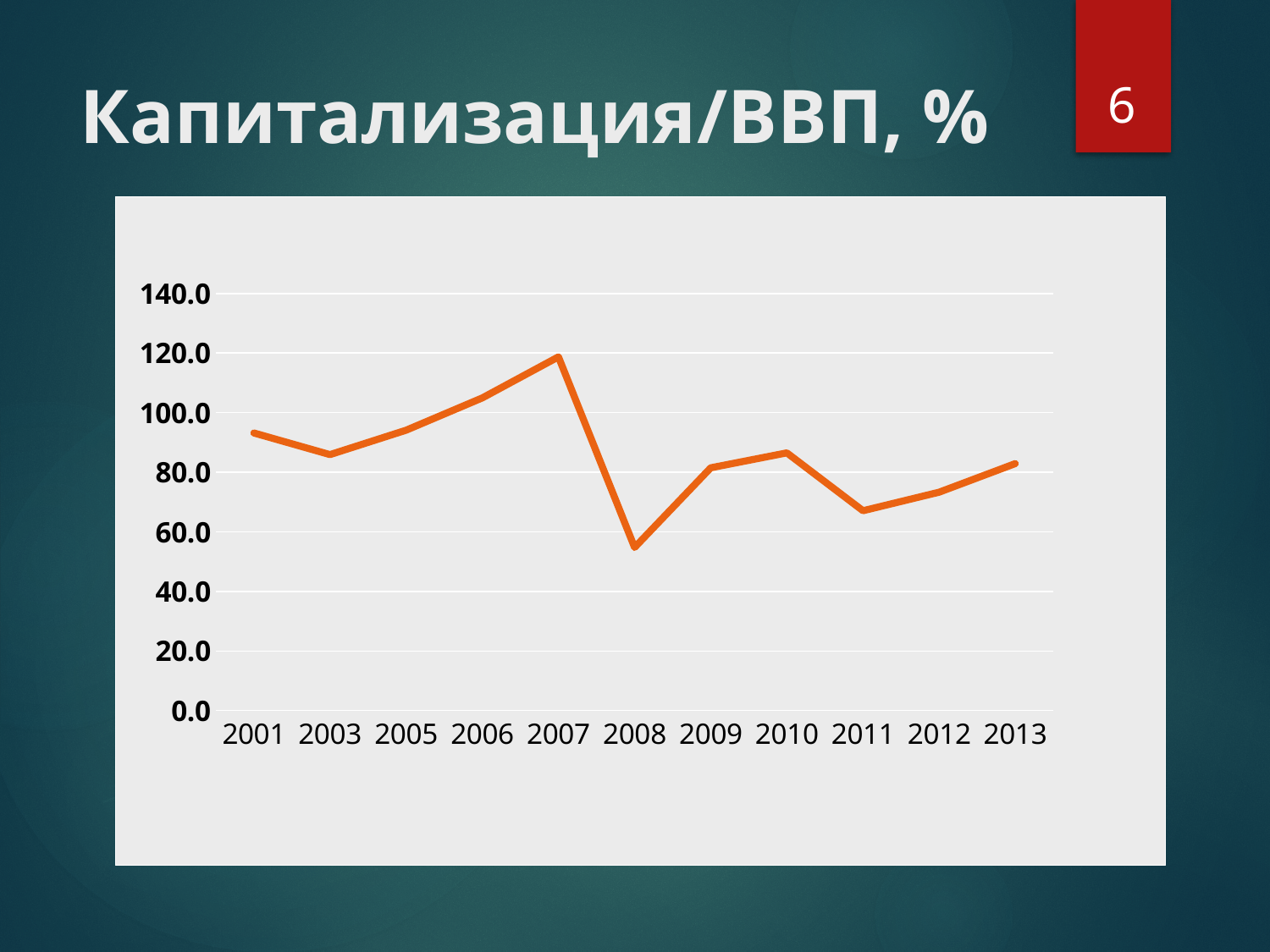
What kind of chart is shown on the slide? line chart How many years are plotted along the x axis? 11 Is the value for 2011 greater or less than 80.0? less Which year has the highest value? 2007 Which is larger, the value for 2010 or the value for 2011? 2010 Is the value for 2007 greater or less than 100.0? greater Do the values rise or fall from 2003 to 2007? rise Which is larger, the value for 2001 or the value for 2003? 2001 Which year has the lowest value? 2008 Is the value for 2008 greater or less than 60.0? less What is the title of the slide containing the chart? Капитализация/ВВП, %